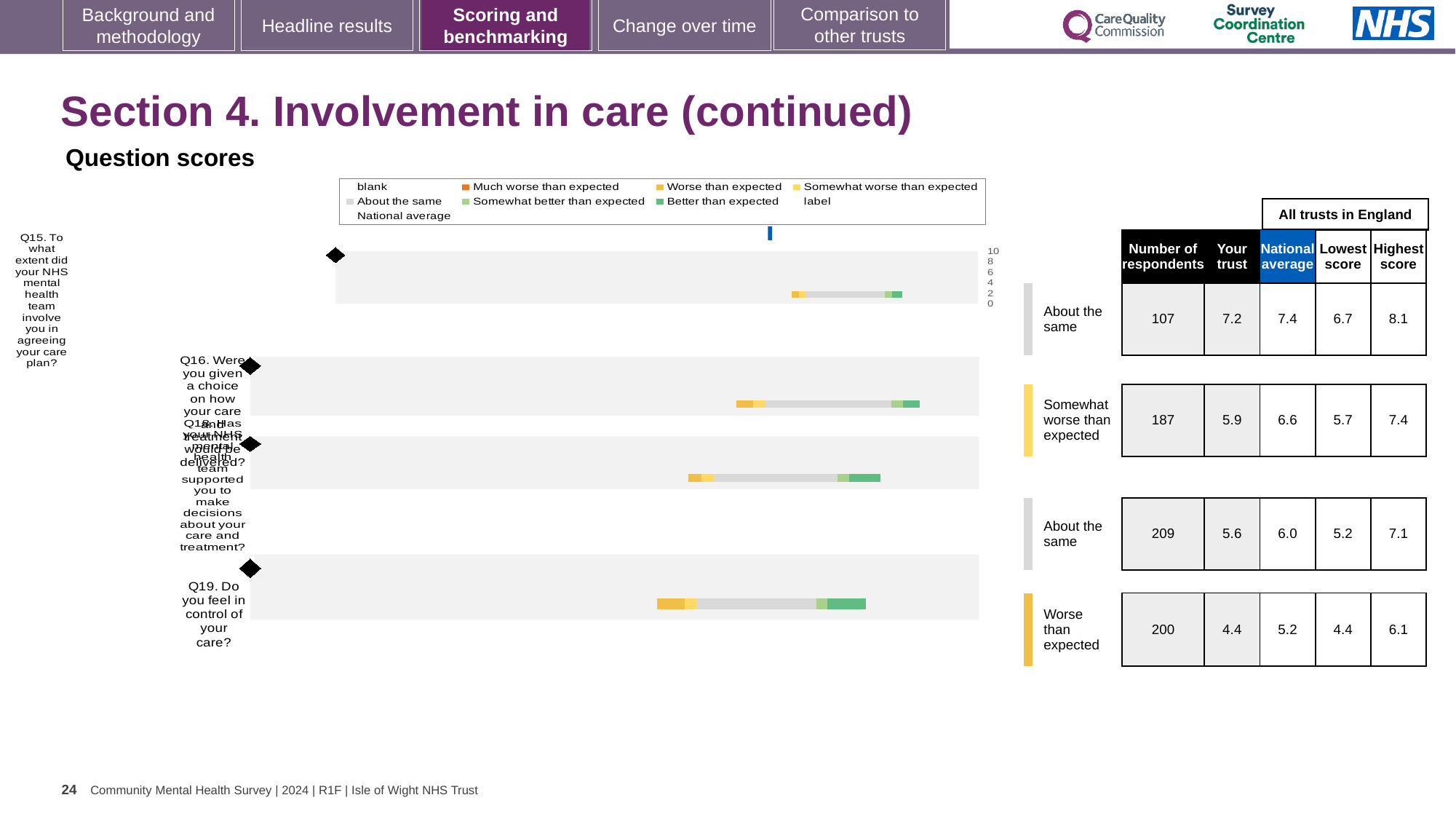
What is the 'Your trust' score for Q19 (Do you feel in control of your care?)? 4.4 What is the difference between the national average and the 'Your trust' score for Q16? 0.7 What is the national average score for Q15 (To what extent did your NHS mental health team involve you in agreeing your care plan?)? 7.4 What kind of chart is used to show the question scores? bar chart How many questions are plotted on the chart? 4 What is the highest score among all trusts in England for Q18 (Has your NHS mental health team supported you to make decisions about your care and treatment?)? 7.1 What benchmark category is shown for Q19? Worse than expected How many respondents answered Q16 (Were you given a choice on how your care and treatment would be delivered?)? 187 Which question has the largest number of respondents? Q18 What is the difference between the highest score and the lowest score for Q15? 1.4 Is the 'Your trust' score for Q15 higher or lower than the national average for Q15? lower Which question has the lowest 'Your trust' score? Q19